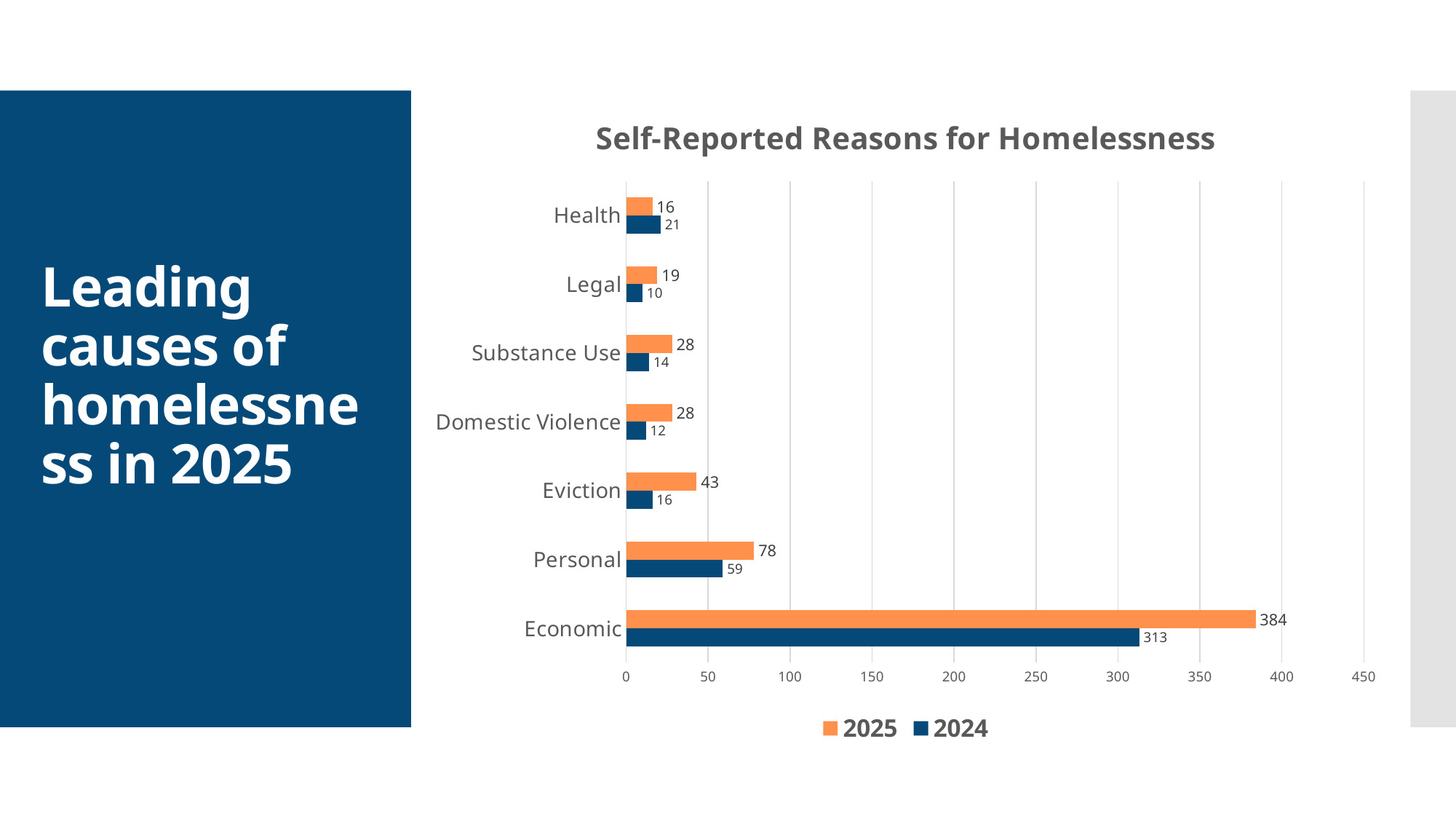
What kind of chart is shown? bar chart What is the title of the chart? Self-Reported Reasons for Homelessness What is the 2024 value for Personal? 59 What is the difference between the 2025 and 2024 values for Economic? 71 What is the 2025 value for Eviction? 43 Which category has the lowest 2024 value? Legal How many categories are shown on the chart? 7 Which is larger for Health, the 2025 value or the 2024 value? 2024 How many series does the legend list? 2 Which category has the highest 2024 value? Economic What is the 2025 value for Economic? 384 Is the 2025 value for Personal greater or less than 50? greater